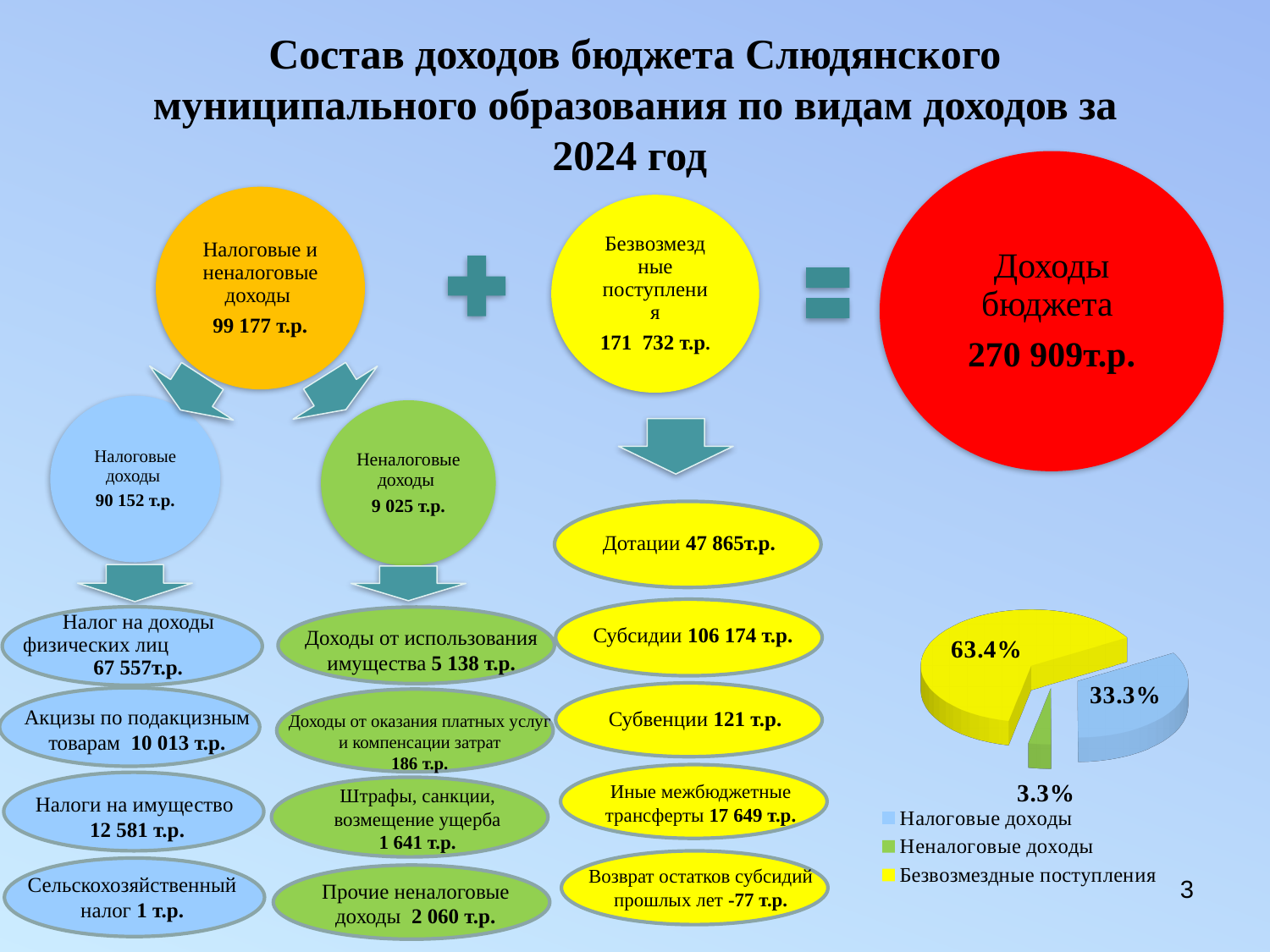
How many slices does the pie chart have? 3 In the pie chart, what share is shown for Безвозмездные поступления? 63.4% How many entries does the pie chart legend list? 3 What kind of chart is shown in the bottom right of the slide? Pie chart In the pie chart, what share is shown for Налоговые доходы? 33.3% In the pie chart, what is the difference between the shares of Налоговые доходы and Неналоговые доходы? 30% Which slice of the pie chart is the largest? Безвозмездные поступления In the pie chart, which is larger: Налоговые доходы or Неналоговые доходы? Налоговые доходы In the pie chart, what share is shown for Неналоговые доходы? 3.3% In the pie chart, what is the difference between the shares of Безвозмездные поступления and Налоговые доходы? 30.1% What colour is the Безвозмездные поступления slice in the pie chart? Yellow Which slice of the pie chart is the smallest? Неналоговые доходы